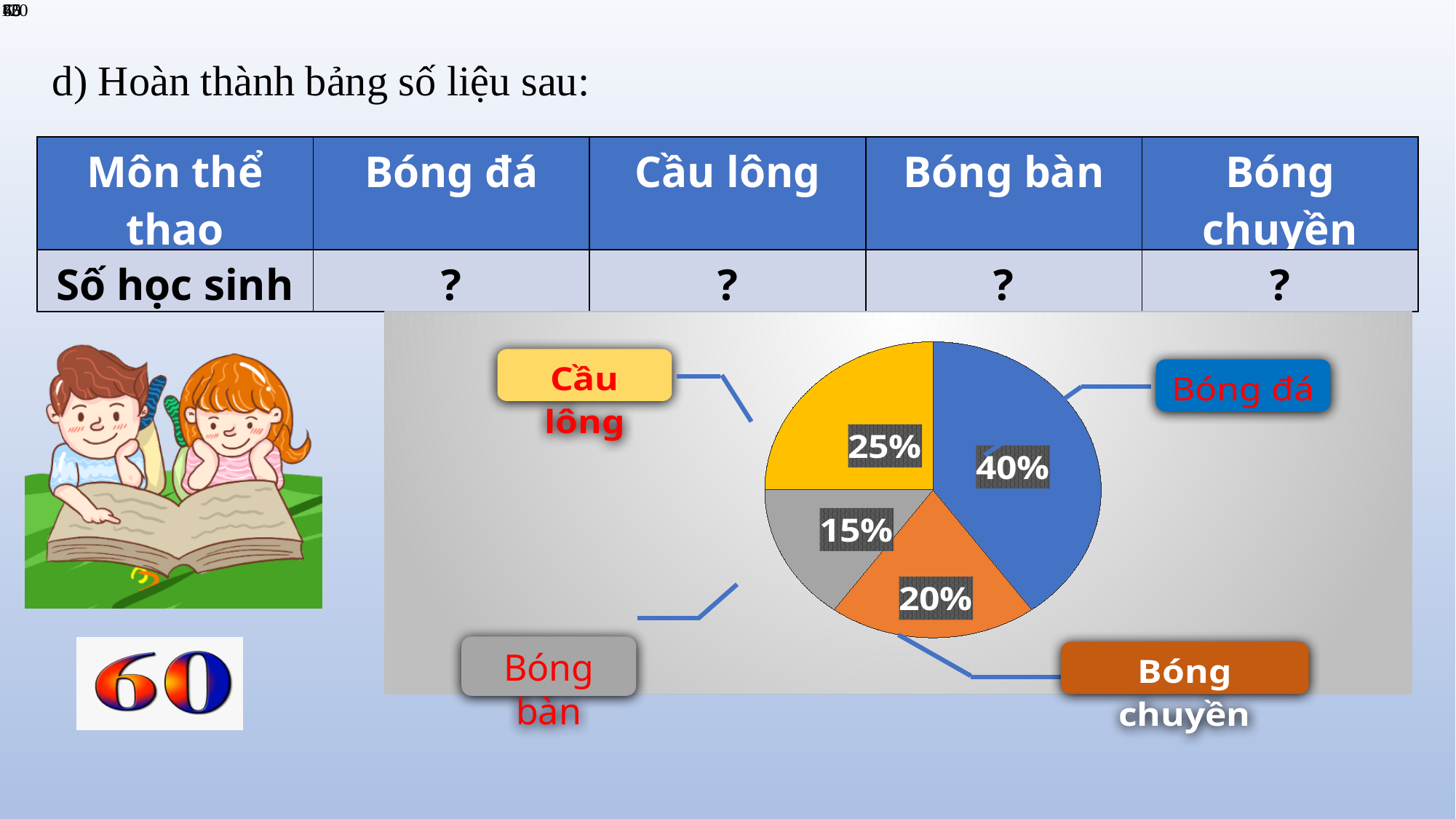
Which slice is larger, Bóng chuyền or Bóng bàn? Bóng chuyền What share of the pie chart does Cầu lông have? 25% What kind of chart is shown on the slide? pie chart What colour is the Cầu lông slice in the pie chart? yellow How many slices does the pie chart have? 4 What share of the pie chart does Bóng bàn have? 15% What colour is the Bóng chuyền slice in the pie chart? orange Which sport has the smallest slice of the pie chart? Bóng bàn What share of the pie chart does Bóng chuyền have? 20% What is the difference in percentage points between the Bóng đá slice and the Cầu lông slice? 15% Which sport has the largest slice of the pie chart? Bóng đá